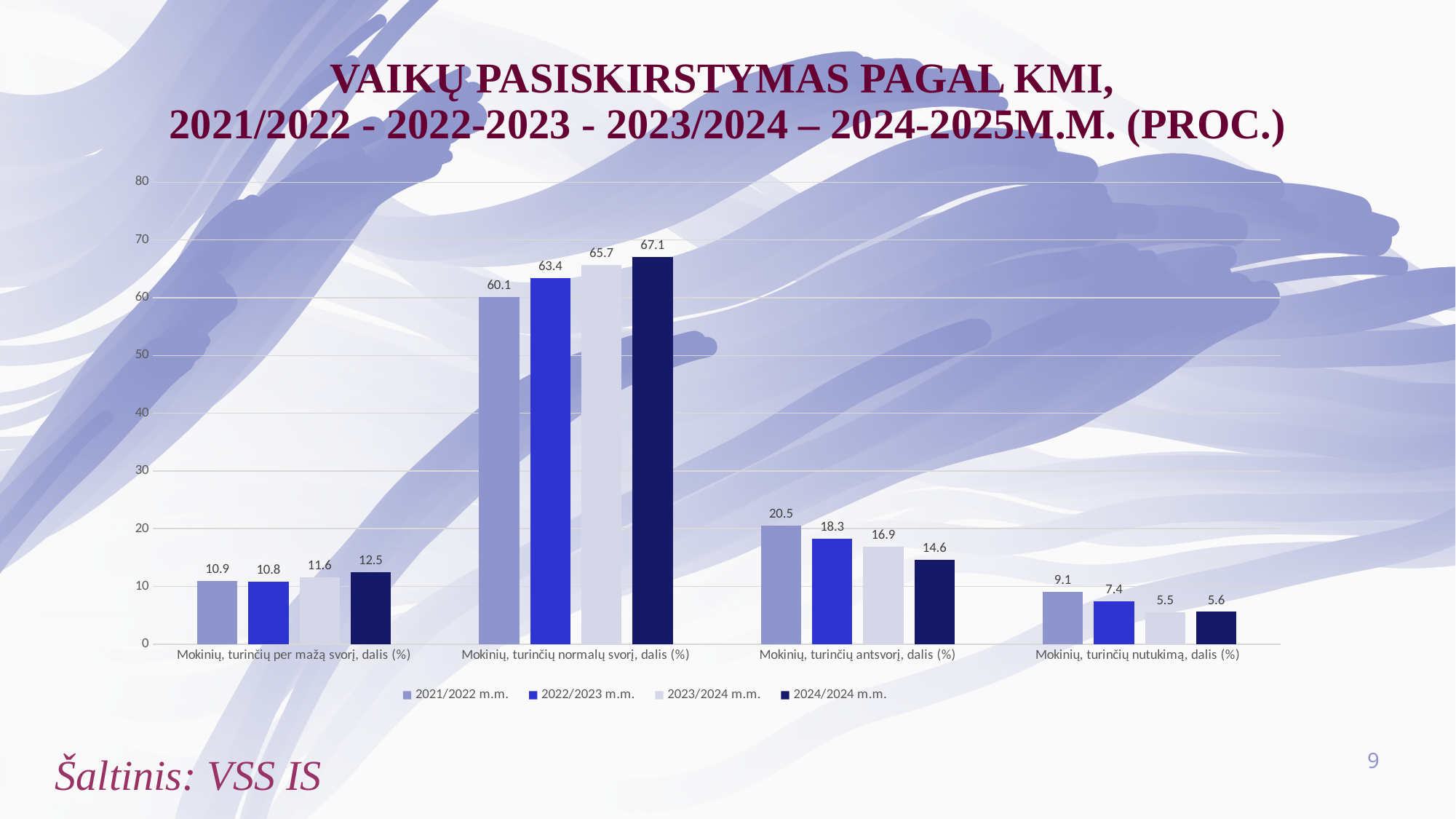
What is the value for 2023/2024 m.m. in the category "Mokinių, turinčių nutukimą, dalis (%)"? 5.5 In the category "Mokinių, turinčių antsvorį, dalis (%)", which is larger: the 2021/2022 m.m. value or the 2023/2024 m.m. value? 2021/2022 m.m. Across the four series from 2021/2022 m.m. to 2024/2024 m.m., do the values in the category "Mokinių, turinčių antsvorį, dalis (%)" rise or fall? fall How many series does the legend list? 4 What is the value for 2021/2022 m.m. in the category "Mokinių, turinčių normalų svorį, dalis (%)"? 60.1 What kind of chart is shown on the slide? bar chart What is the difference between the 2024/2024 m.m. and 2021/2022 m.m. values in the category "Mokinių, turinčių normalų svorį, dalis (%)"? 7.0 Which category has the lowest value for the 2021/2022 m.m. series? Mokinių, turinčių nutukimą, dalis (%) Which category has the highest value for the 2022/2023 m.m. series? Mokinių, turinčių normalų svorį, dalis (%) Is the value for 2022/2023 m.m. in the category "Mokinių, turinčių normalų svorį, dalis (%)" greater or less than 60? greater What is the value for 2024/2024 m.m. in the category "Mokinių, turinčių antsvorį, dalis (%)"? 14.6 How many categories are shown on the x axis of the chart? 4